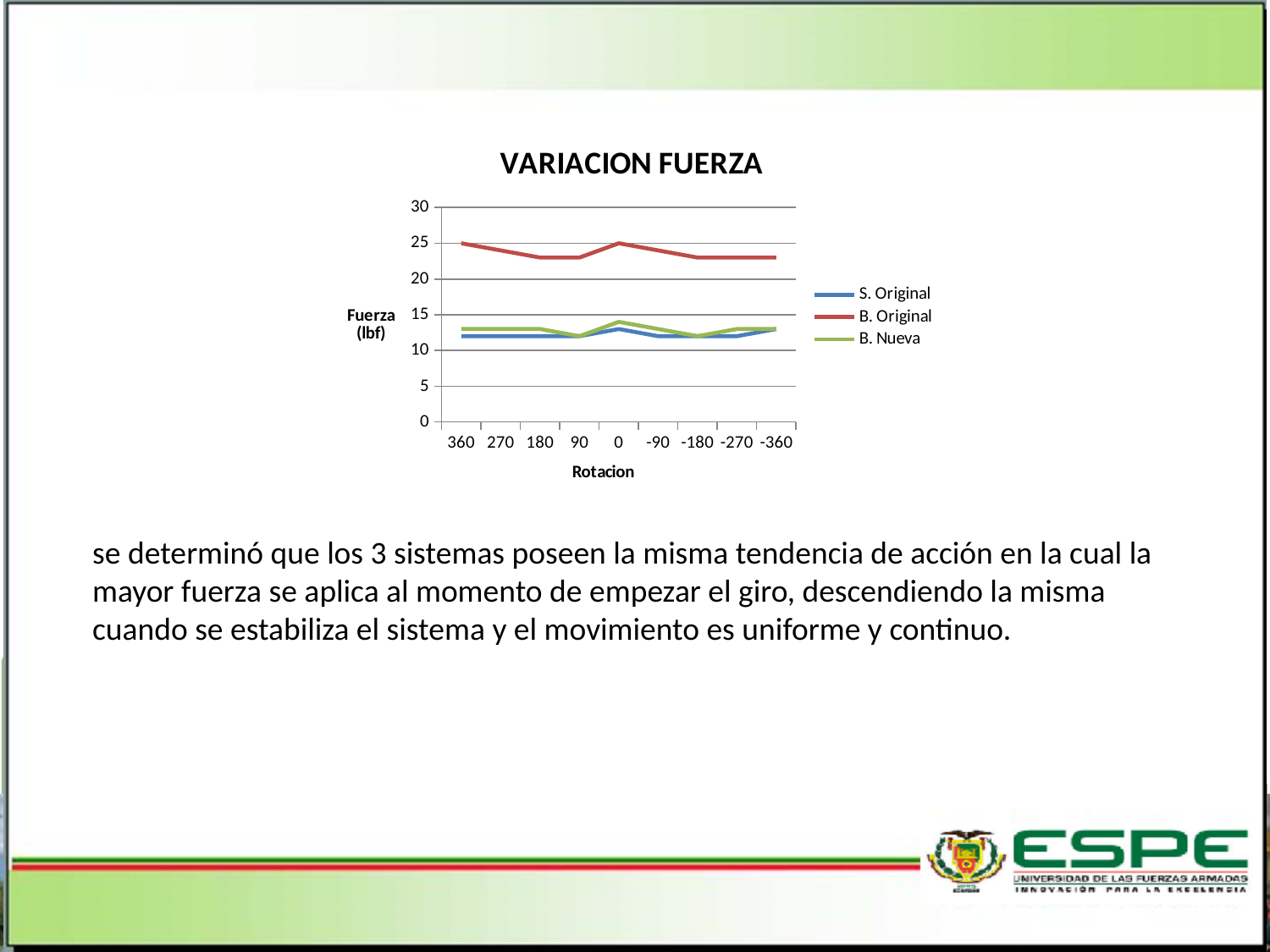
What is the title of the chart? VARIACION FUERZA At rotation 0, which is larger: B. Original or S. Original? B. Original What kind of chart is shown on the slide? line chart Which series has the highest values across the chart? B. Original Is the value for S. Original at rotation 360 greater or less than 10? greater How many rotation values are plotted along the x axis? 9 Does the B. Original line rise or fall from rotation 360 to rotation 180? fall What is the label on the vertical axis? Fuerza (lbf) Is the value for B. Original at rotation 180 greater or less than 25? less How many series does the legend list? 3 Is the value for B. Original at rotation 360 greater or less than 20? greater